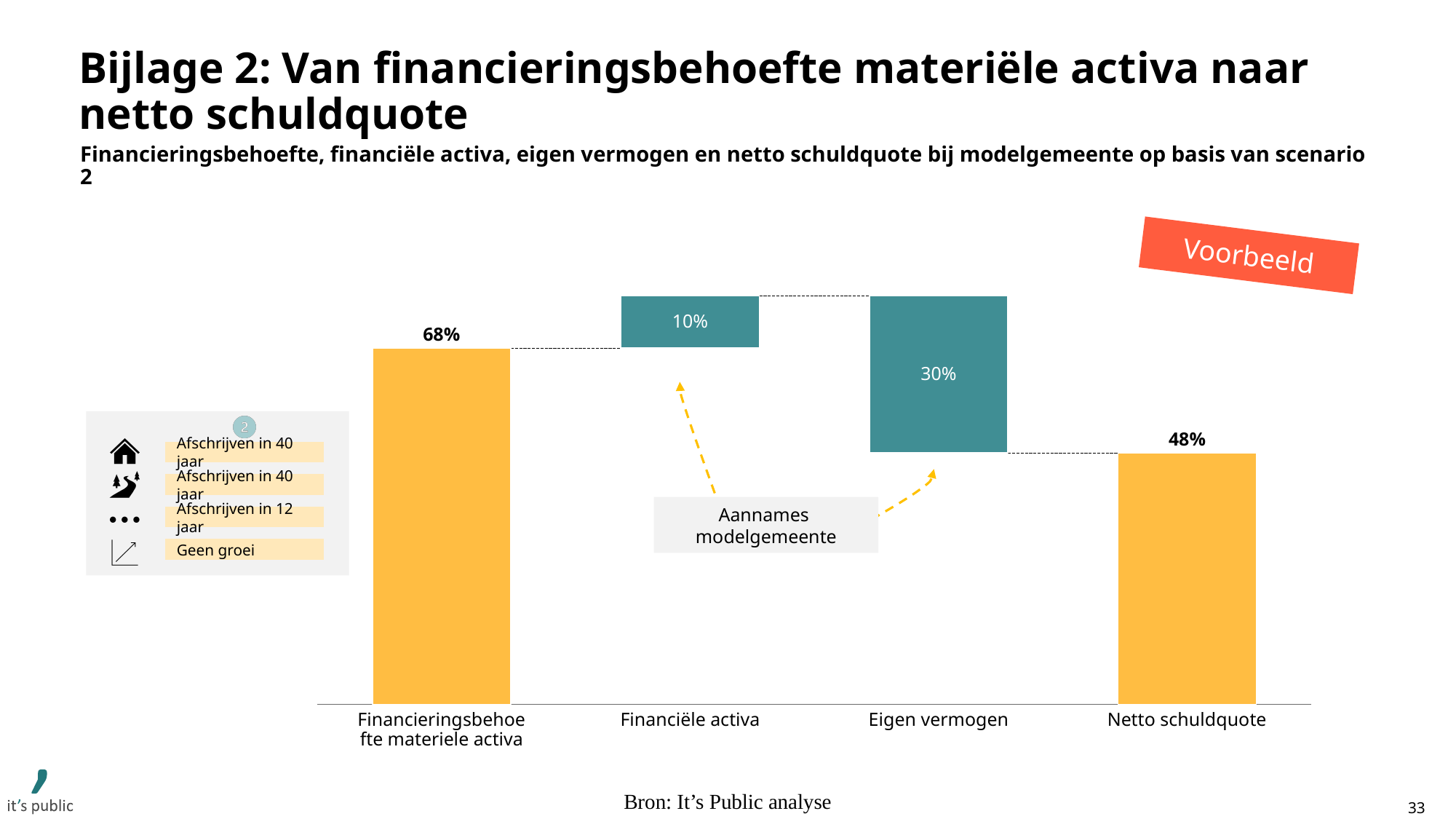
Which category has the highest labelled value? Financieringsbehoefte materiele activa What is the value shown for Eigen vermogen? 30% What colour are the bars for Financiële activa and Eigen vermogen? Teal What is the difference between the value for Financieringsbehoefte materiele activa and the value for Netto schuldquote? 20% How many categories are shown on the x axis of the chart? 4 Which category has the lowest labelled value? Financiële activa What is the value shown for Financiële activa? 10% What is the value shown for Netto schuldquote? 48% Which is larger, the value for Eigen vermogen or the value for Financiële activa? Eigen vermogen What kind of chart is shown on the slide? Bar chart What is the value shown for Financieringsbehoefte materiele activa? 68% What is the source cited below the chart? Bron: It's Public analyse